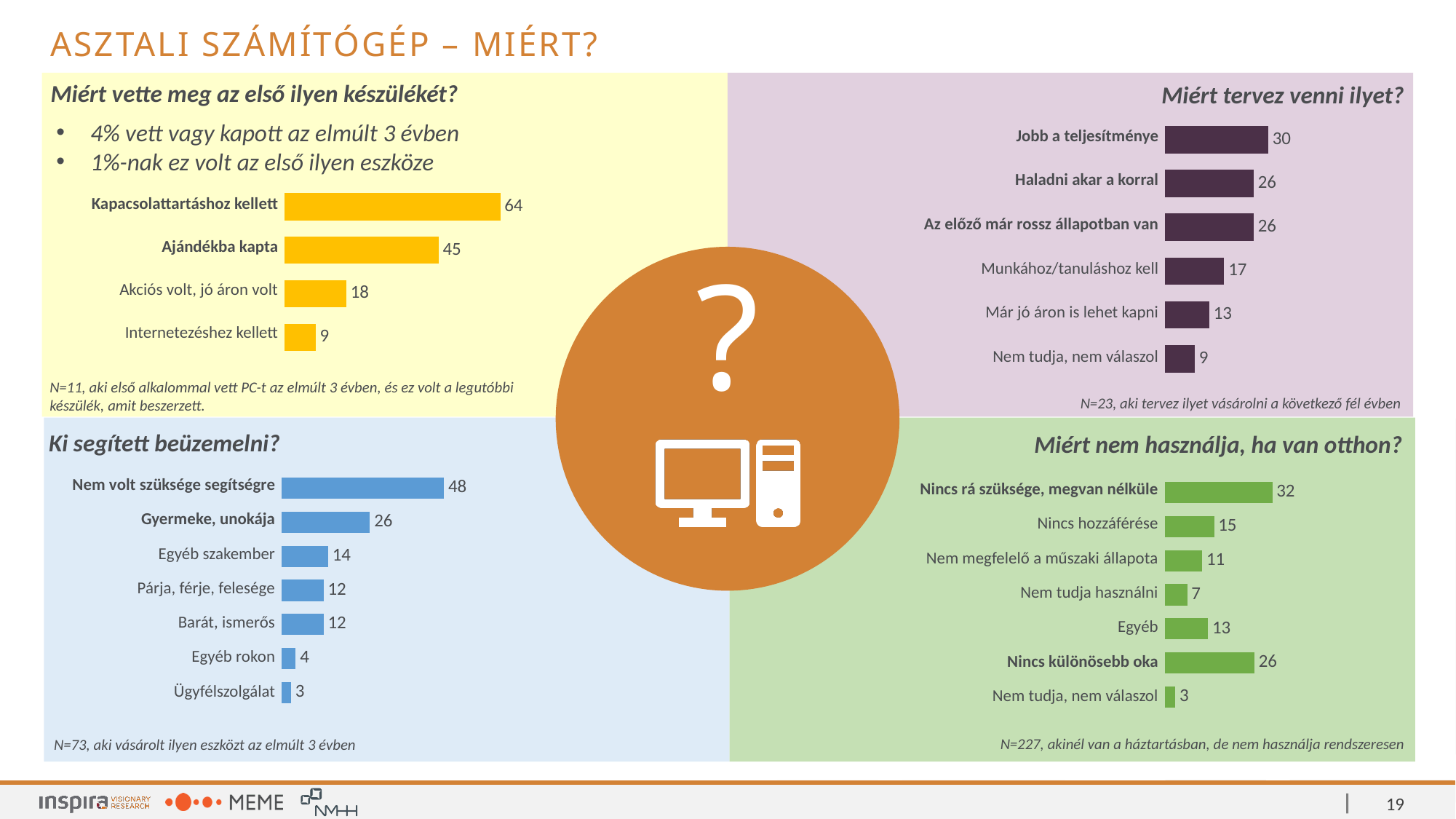
What type of chart is used in the 'Ki segített beüzemelni?' section? Bar chart In the chart 'Miért tervez venni ilyet?', how many categories are shown? 6 In the chart 'Miért tervez venni ilyet?', what is the value for 'Jobb a teljesítménye'? 30 In the chart 'Miért nem használja, ha van otthon?', which is larger: 'Nincs hozzáférése' or 'Egyéb'? Nincs hozzáférése In the chart 'Miért vette meg az első ilyen készülékét?', which category has the lowest value? Internetezéshez kellett In the chart 'Ki segített beüzemelni?', how many categories are shown? 7 In the chart 'Ki segített beüzemelni?', what is the value for 'Egyéb szakember'? 14 In the chart 'Miért nem használja, ha van otthon?', what is the difference between 'Nincs rá szüksége, megvan nélküle' and 'Nem tudja, nem válaszol'? 29 In the chart 'Miért tervez venni ilyet?', what is the difference between 'Jobb a teljesítménye' and 'Munkához/tanuláshoz kell'? 13 In the chart 'Ki segített beüzemelni?', which category has the highest value? Nem volt szüksége segítségre In the chart 'Miért vette meg az első ilyen készülékét?', what is the value for 'Kapacsolattartáshoz kellett'? 64 In the chart 'Miért nem használja, ha van otthon?', what is the value for 'Nincs különösebb oka'? 26